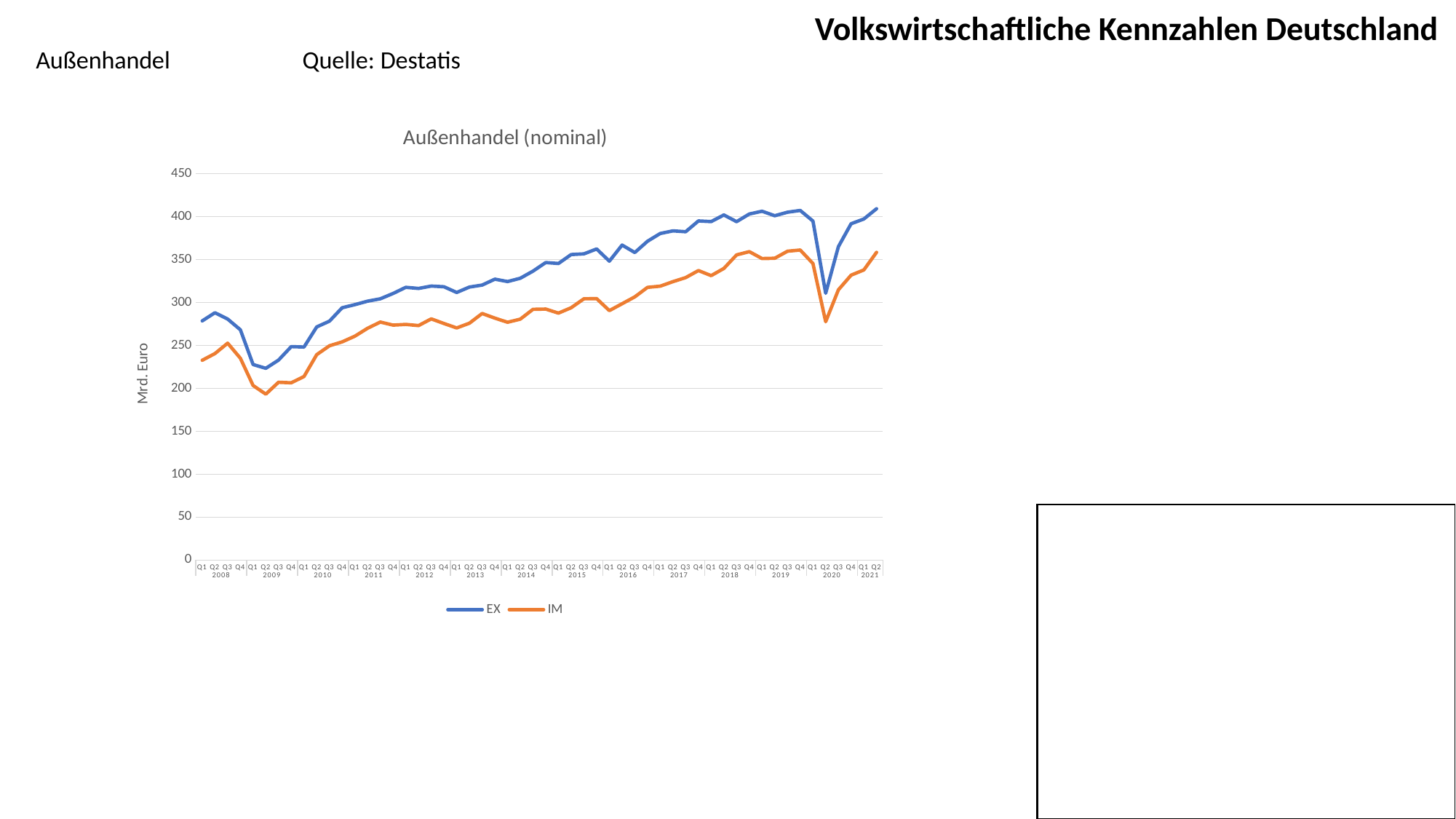
Is the value of EX in Q1 2008 greater or less than 250? greater What is the label of the vertical axis of the chart? Mrd. Euro Is the value of IM in Q4 2019 greater or less than 300? greater Is the value of EX in Q2 2020 greater or less than 350? less How many series does the legend of the chart list? 2 Which series has the larger value in Q1 2008, EX or IM? EX Does the EX series rise or fall from Q1 2008 to Q1 2009? fall What is the title of the chart? Außenhandel (nominal) What kind of chart is shown on the slide? line chart In which quarter does the IM series reach its lowest value? Q2 2009